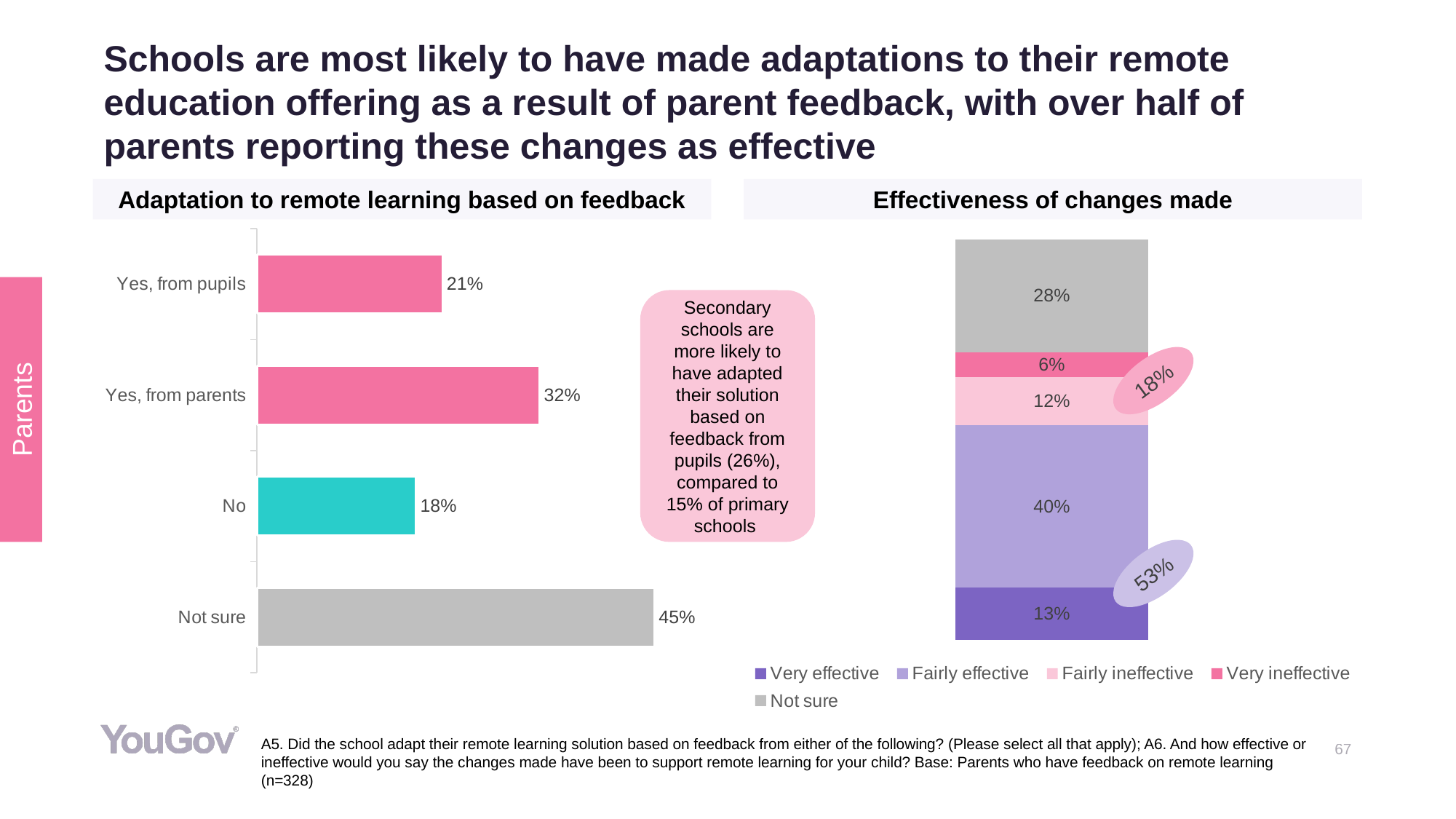
In the 'Adaptation to remote learning based on feedback' chart, which category has the lowest value? No How many categories are shown in the 'Adaptation to remote learning based on feedback' chart? 4 How many series does the legend of the 'Effectiveness of changes made' chart list? 5 What kind of chart is the 'Adaptation to remote learning based on feedback' chart? Bar chart In the 'Effectiveness of changes made' chart, what is the value for 'Very ineffective'? 6% In the 'Adaptation to remote learning based on feedback' chart, what is the value for 'Yes, from parents'? 32% In the 'Adaptation to remote learning based on feedback' chart, which is larger: 'Yes, from pupils' or 'No'? Yes, from pupils In the 'Effectiveness of changes made' chart, which is larger: 'Not sure' or 'Very effective'? Not sure In the 'Adaptation to remote learning based on feedback' chart, what is the difference between 'Yes, from parents' and 'Yes, from pupils'? 11% In the 'Adaptation to remote learning based on feedback' chart, which category has the highest value? Not sure In the 'Effectiveness of changes made' chart, what is the value for 'Fairly effective'? 40% In the 'Effectiveness of changes made' chart, what is the combined total of 'Very effective' and 'Fairly effective'? 53%